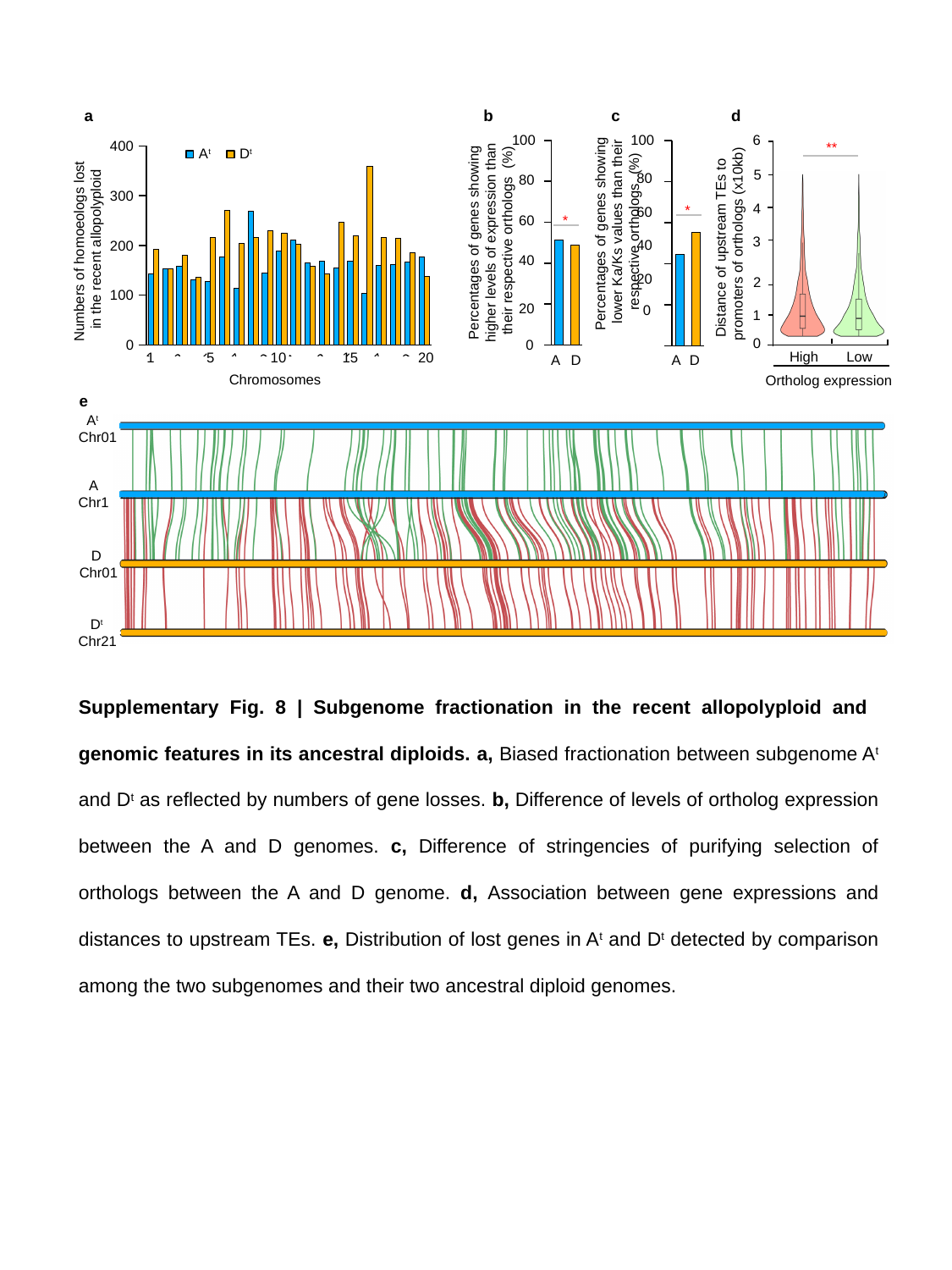
In panel b, which bar is taller, A or D? A In panel a, is the Dt value for chromosome 15 greater or less than 200? greater In panel a, how many chromosomes are shown along the x axis? 20 In panel c, is the value for A greater or less than 40? greater In panel c, which bar is taller, A or D? D In panel a, is the At value for chromosome 1 greater or less than 200? less In panel a, what kind of chart is shown? bar chart In panel a, how many series does the legend list? 2 In panel a, what are the two series named in the legend? At and Dt In panel a, which series contains the single tallest bar in the chart? Dt